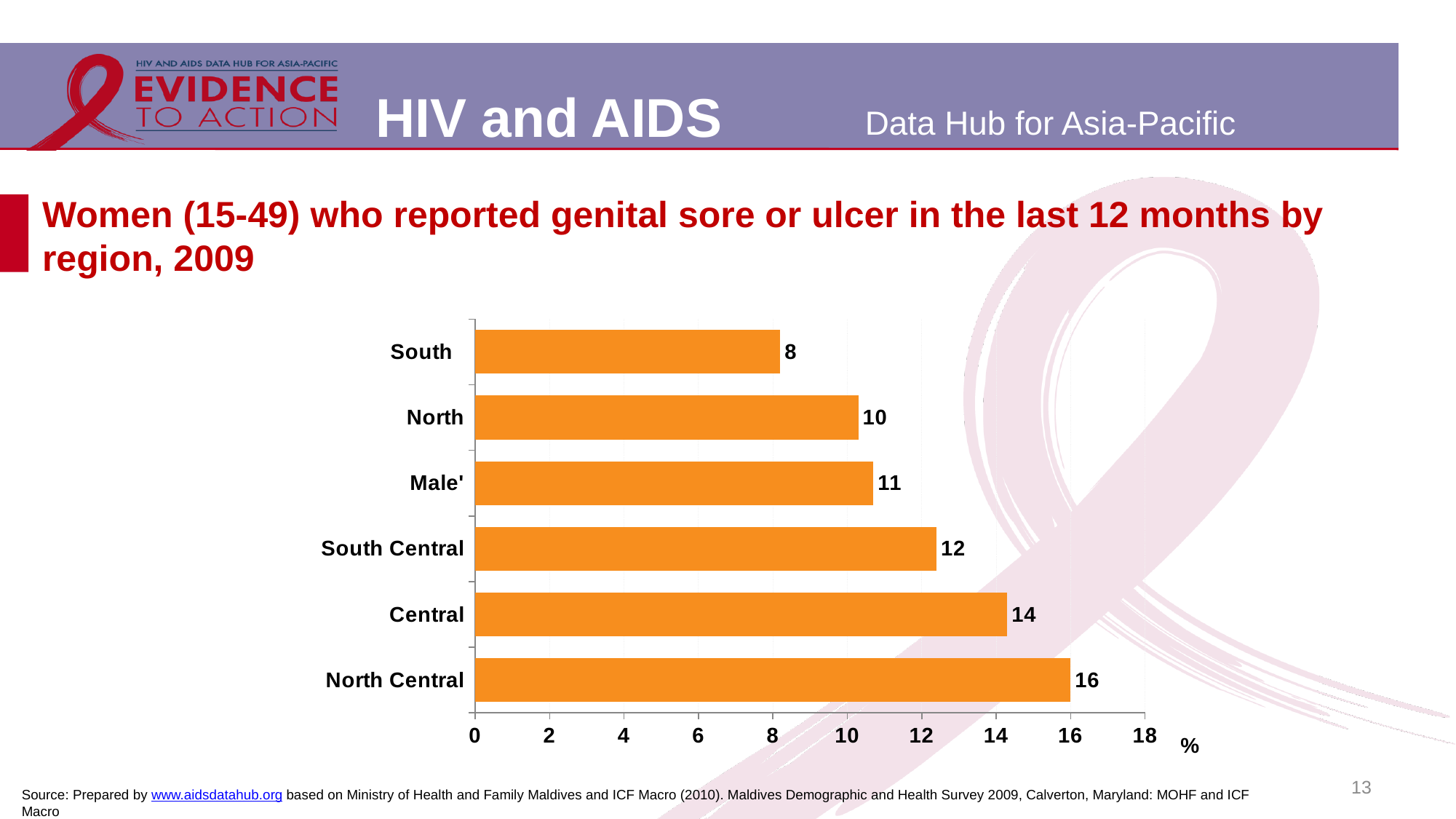
Which has a higher value, South Central or North? South Central What is the difference between the values for North Central and South? 8 How many regions are shown in the chart? 6 What type of chart is shown on the slide? Bar chart What is the value shown for the South region? 8 What unit is shown on the horizontal axis of the chart? % Which region has the highest percentage of women reporting a genital sore or ulcer? North Central What is the value shown for Male'? 11 Which region has the lowest percentage of women reporting a genital sore or ulcer? South What colour are the bars in the chart? Orange What is the difference between the values for Central and North? 4 What percentage of women in North Central reported a genital sore or ulcer in the last 12 months? 16